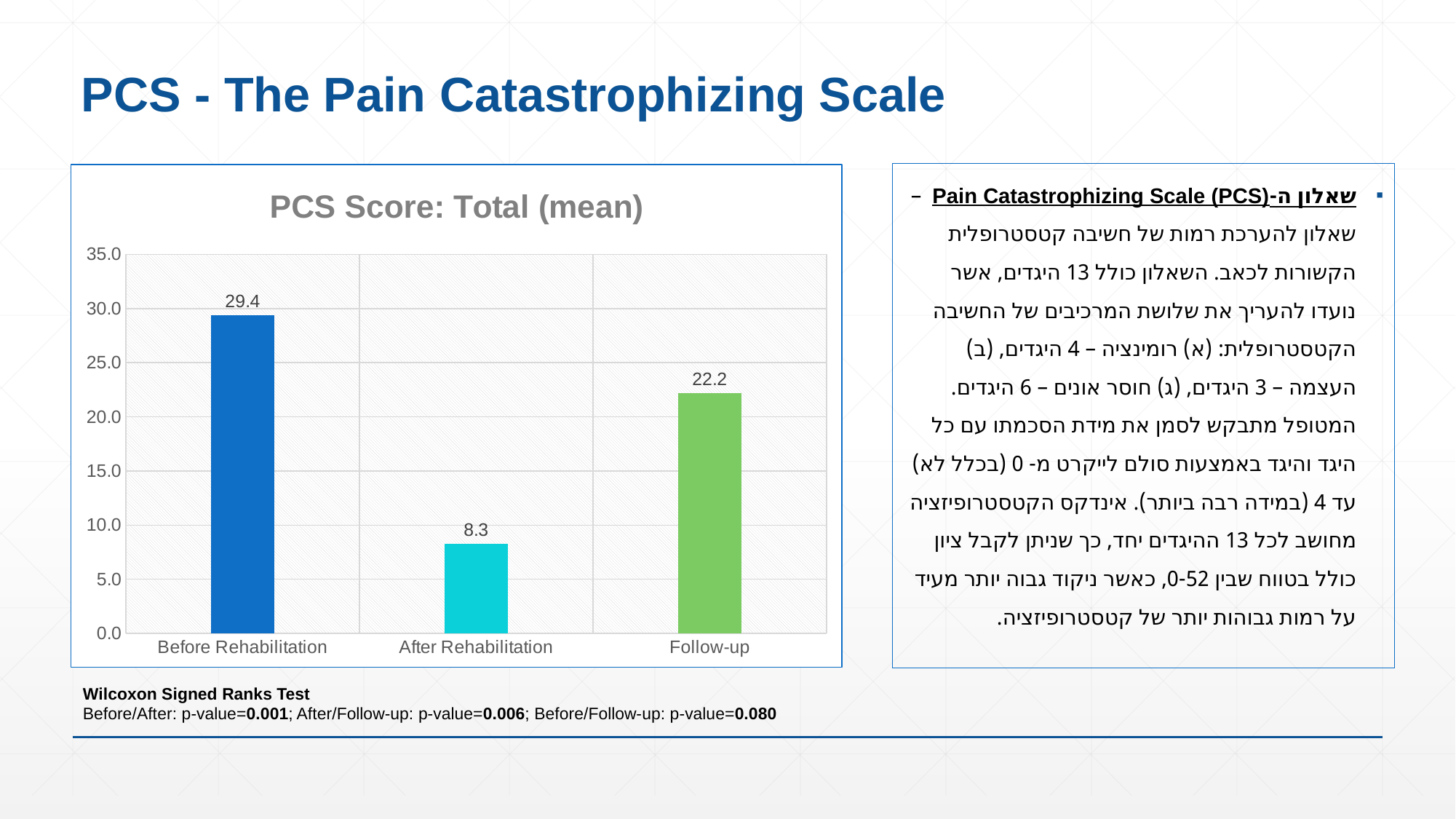
Which is larger, the PCS score at Follow-up or Before Rehabilitation? Before Rehabilitation What kind of chart is shown on the slide? bar chart What is the PCS score for After Rehabilitation? 8.3 How many categories are shown in the chart? 3 Which category has the highest PCS score? Before Rehabilitation What is the difference between the Before Rehabilitation and After Rehabilitation PCS scores? 21.1 What is the title of the chart? PCS Score: Total (mean) What is the PCS score at Follow-up? 22.2 What is the PCS score for Before Rehabilitation? 29.4 Which category has the lowest PCS score? After Rehabilitation What is the difference between the Follow-up and After Rehabilitation PCS scores? 13.9 Is the value for After Rehabilitation greater or less than 10.0? less